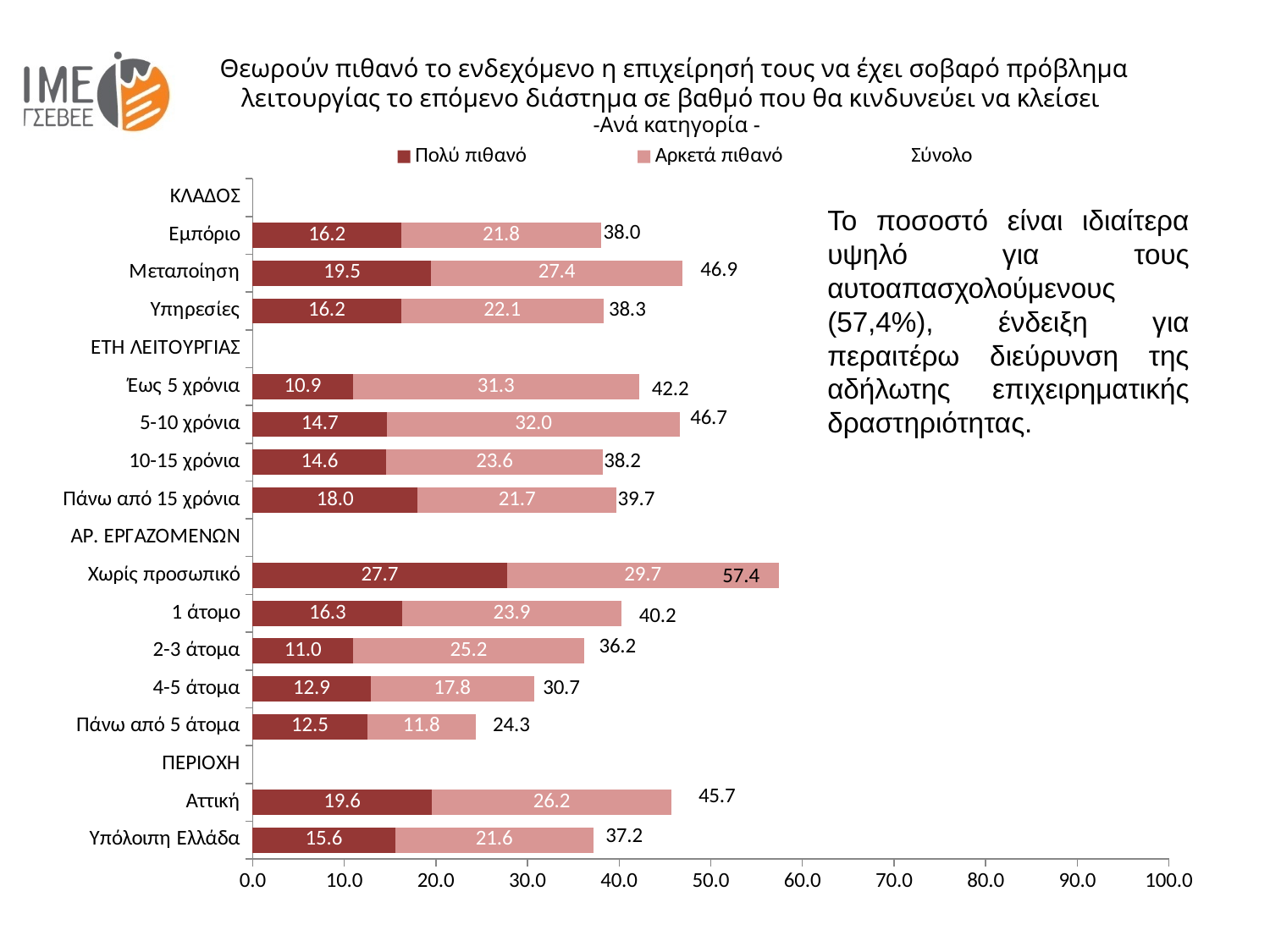
How many categories have bars plotted in the chart? 14 Is the total value for 5-10 χρόνια greater or less than 40.0? greater How many entries does the legend list? 3 What is the "Πολύ πιθανό" value for Μεταποίηση? 19.5 What is the total (Σύνολο) value for Χωρίς προσωπικό? 57.4 Which category has the highest total value? Χωρίς προσωπικό What is the "Αρκετά πιθανό" value for Πάνω από 5 άτομα? 11.8 Which category has the lowest total value? Πάνω από 5 άτομα What is the "Αρκετά πιθανό" value for Έως 5 χρόνια? 31.3 What is the difference between the total values for Αττική and Υπόλοιπη Ελλάδα? 8.5 Which has a larger "Πολύ πιθανό" value, Εμπόριο or Μεταποίηση? Μεταποίηση What type of chart is shown on the slide? stacked bar chart